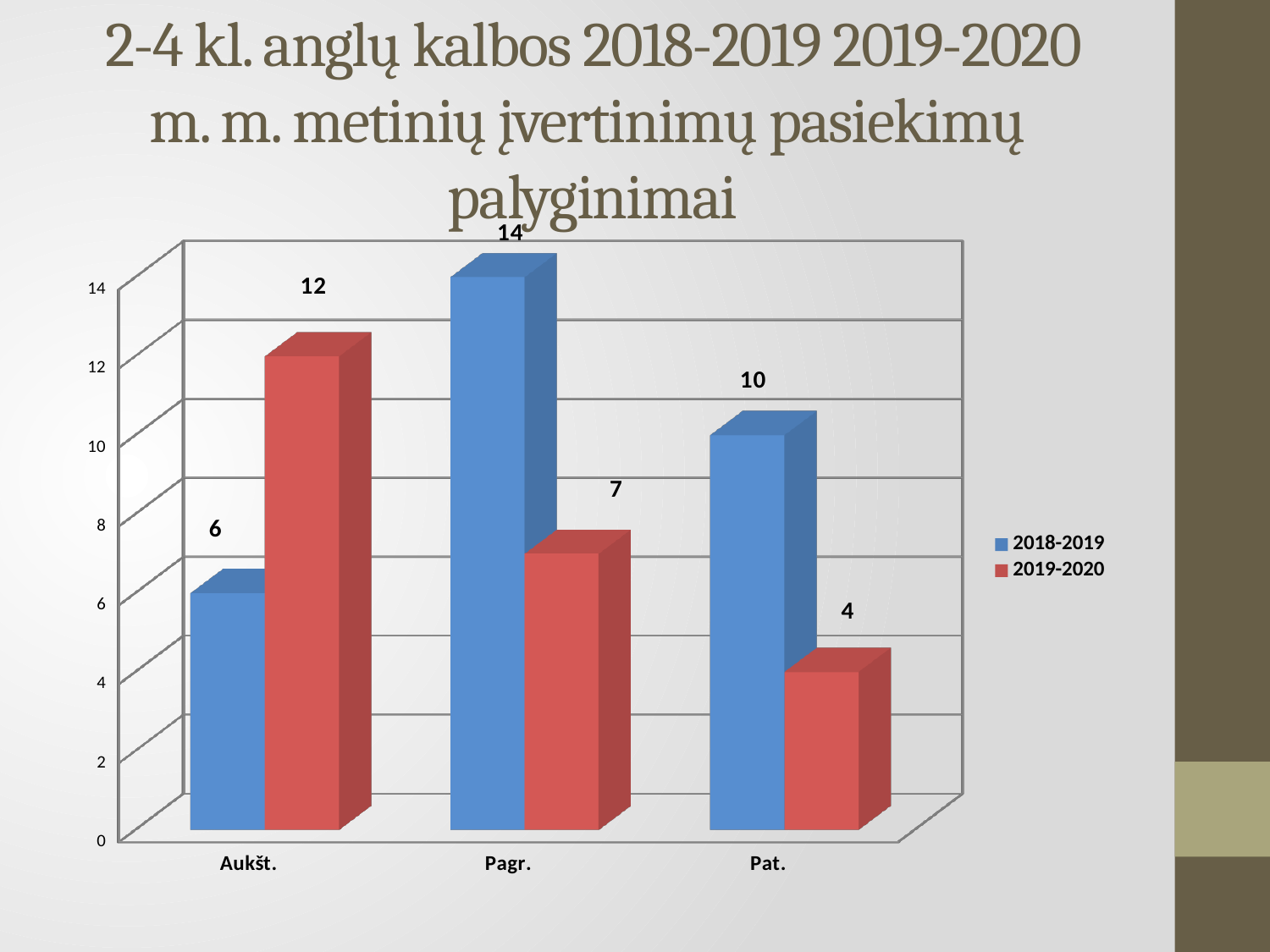
Which category has the highest value in the 2018-2019 series? Pagr. What is the value for Pagr. in the 2019-2020 series? 7 What kind of chart is shown on the slide? bar chart What is the difference between the 2019-2020 values for Aukšt. and Pagr.? 5 Which category has the lowest value in the 2019-2020 series? Pat. How many series does the legend list? 2 Which is larger for Aukšt.: the 2018-2019 value or the 2019-2020 value? 2019-2020 Which colour represents the 2019-2020 series? red What is the value for Aukšt. in the 2018-2019 series? 6 What is the value for Pat. in the 2018-2019 series? 10 How many categories are shown on the x axis? 3 What is the difference between the 2018-2019 and 2019-2020 values for Pat.? 6